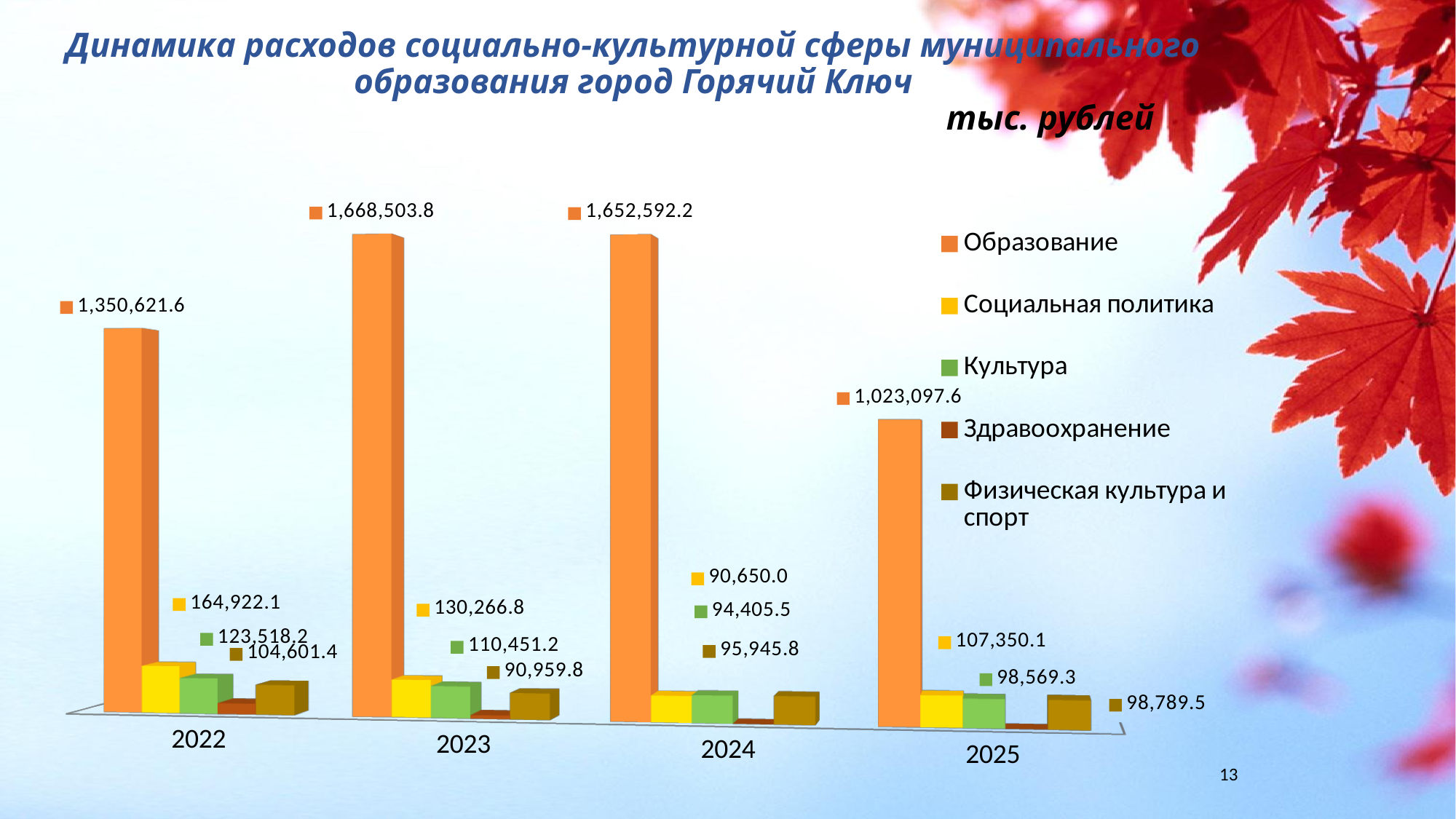
In which year is the value for Образование the highest? 2023 What is the value for Социальная политика in 2022? 164,922.1 What unit is stated for the values on the slide? тыс. рублей How many series does the legend list? 5 What is the value for Образование in 2023? 1,668,503.8 What is the value for Физическая культура и спорт in 2025? 98,789.5 What is the difference between the Образование values for 2023 and 2024? 15,911.6 What is the value for Культура in 2024? 94,405.5 What kind of chart is shown on the slide? Bar chart Which is larger in 2025: Социальная политика or Культура? Социальная политика How many years are shown on the x axis? 4 In which year is the value for Образование the lowest? 2025